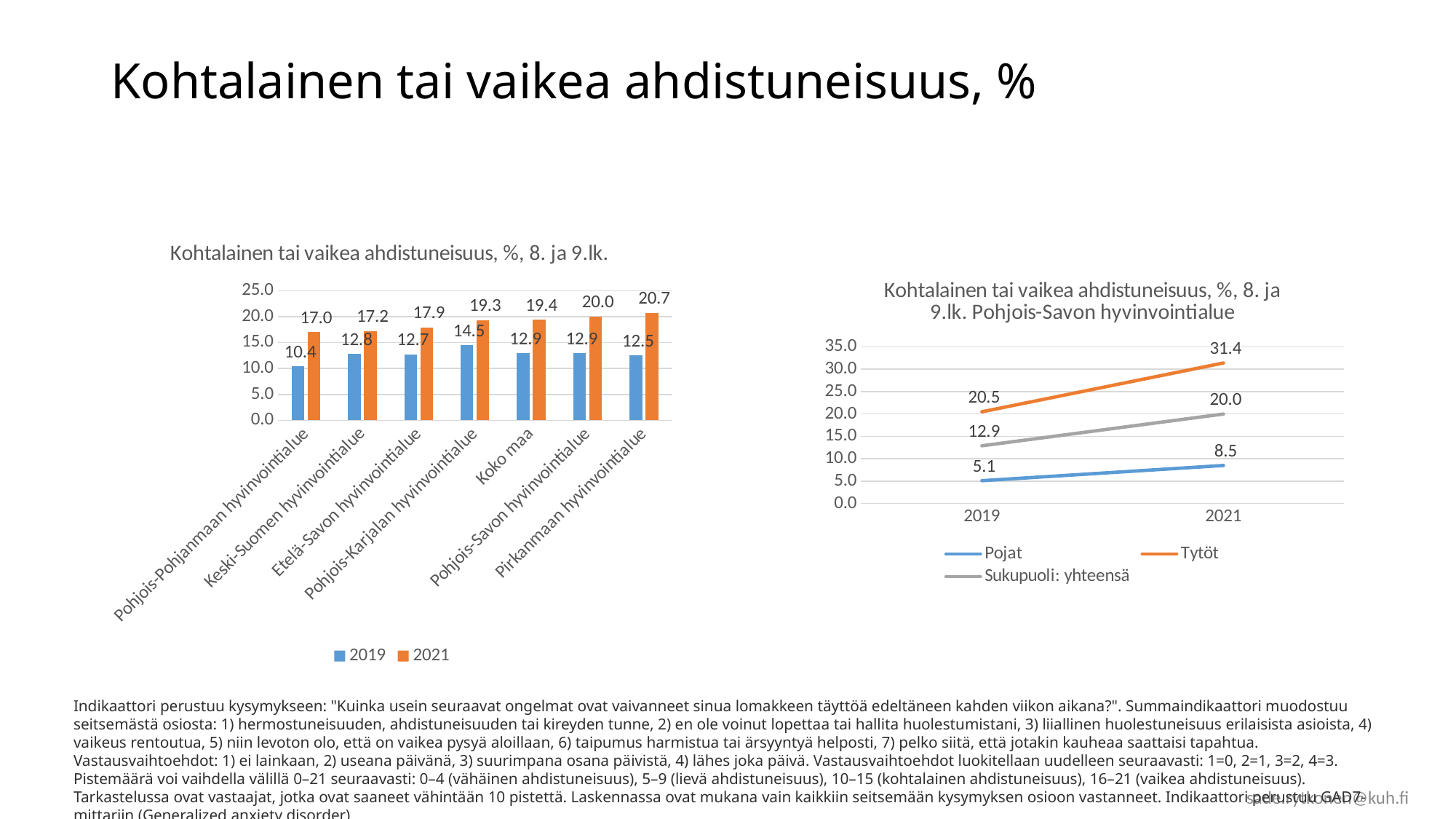
In the left chart (Kohtalainen tai vaikea ahdistuneisuus, %, 8. ja 9.lk.), what is the 2021 value for Pirkanmaan hyvinvointialue? 20.7 In the right chart, does the Pojat line rise or fall from 2019 to 2021? Rise What kind of chart is the left chart? Bar chart In the left chart, which category has the highest 2021 value? Pirkanmaan hyvinvointialue In the left chart, what is the 2019 value for Pohjois-Karjalan hyvinvointialue? 14.5 In the right chart, how many series does the legend list? 3 In the left chart, which category has the lowest 2019 value? Pohjois-Pohjanmaan hyvinvointialue In the left chart, how many categories are shown on the x axis? 7 In the right chart, what is the difference between the Tytöt and Pojat values in 2019? 15.4 In the left chart, how many series does the legend list? 2 In the right chart (Pohjois-Savon hyvinvointialue), what is the value for Tytöt in 2021? 31.4 In the left chart, what is the difference between the 2021 and 2019 values for Koko maa? 6.5